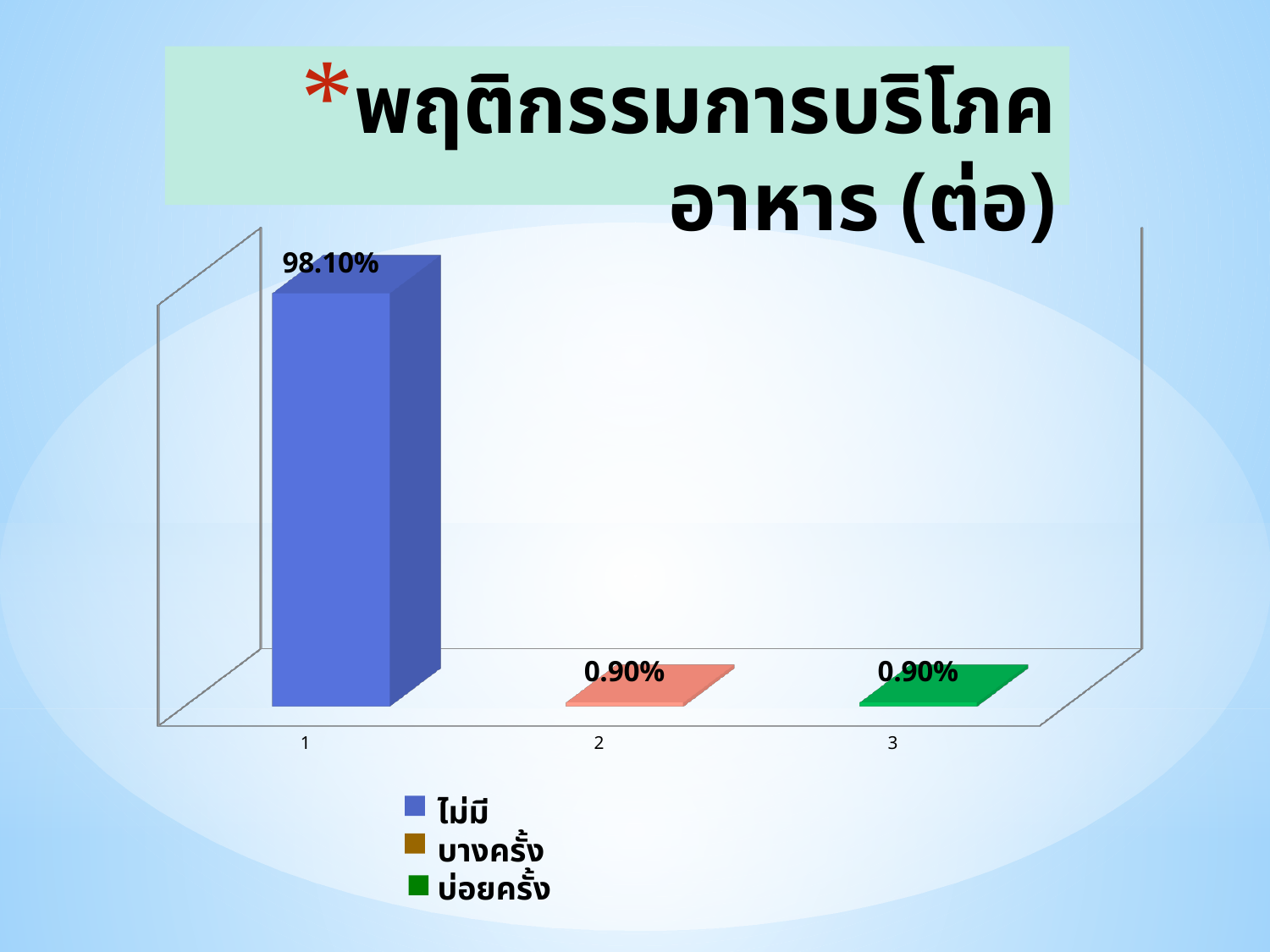
What is the title of the slide? พฤติกรรมการบริโภคอาหาร (ต่อ) What is the value shown for category 3? 0.90% What kind of chart is shown on the slide? Bar chart What is the difference between the values for category 1 and category 2? 97.20% How many categories are shown on the x axis? 3 Which legend entry is shown in blue? ไม่มี What is the value shown for category 2? 0.90% Which is larger, the value for category 1 or the value for category 3? Category 1 What is the value shown for category 1? 98.10% Which category has the highest value? 1 What is the total of the three values shown on the chart? 99.90% How many entries does the legend list? 3